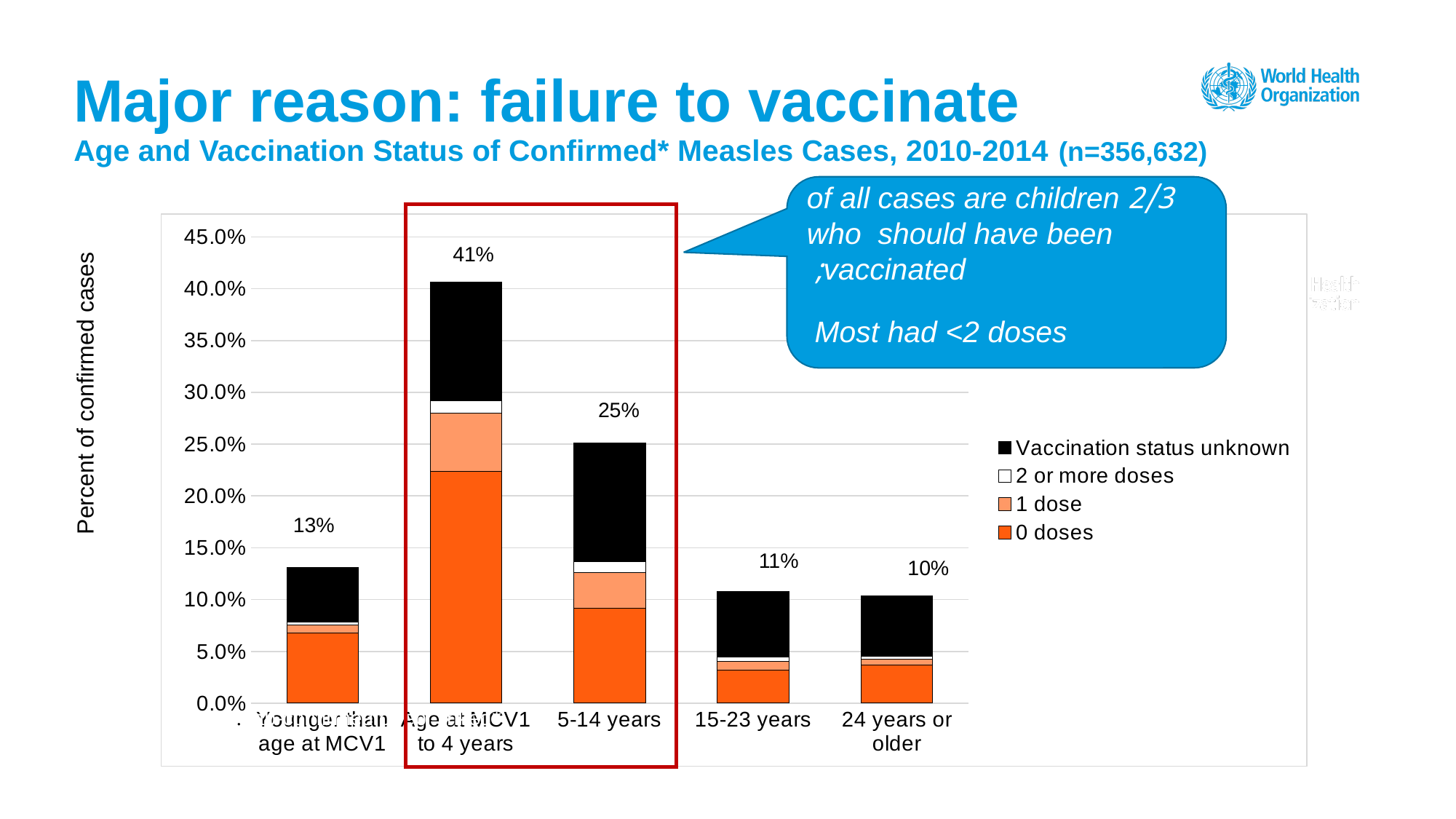
Which age group has the lowest percentage of confirmed cases? 24 years or older Which has a larger labelled percentage of confirmed cases: '15-23 years' or 'Younger than age at MCV1'? Younger than age at MCV1 What percentage of confirmed cases is labelled for the 'Age at MCV1 to 4 years' bar? 41% Which age group has the highest percentage of confirmed cases? Age at MCV1 to 4 years What is the difference between the labelled percentages for 'Age at MCV1 to 4 years' and '5-14 years'? 16% What percentage of confirmed cases is labelled for the 'Younger than age at MCV1' bar? 13% Is the '0 doses' segment for 'Age at MCV1 to 4 years' greater or less than 20.0%? greater What percentage of confirmed cases is labelled for the '5-14 years' bar? 25% What kind of chart is shown on the slide? Stacked bar chart How many age groups are shown on the x axis? 5 How many series does the legend list? 4 Do the labelled total percentages rise or fall from 'Age at MCV1 to 4 years' to '24 years or older'? fall